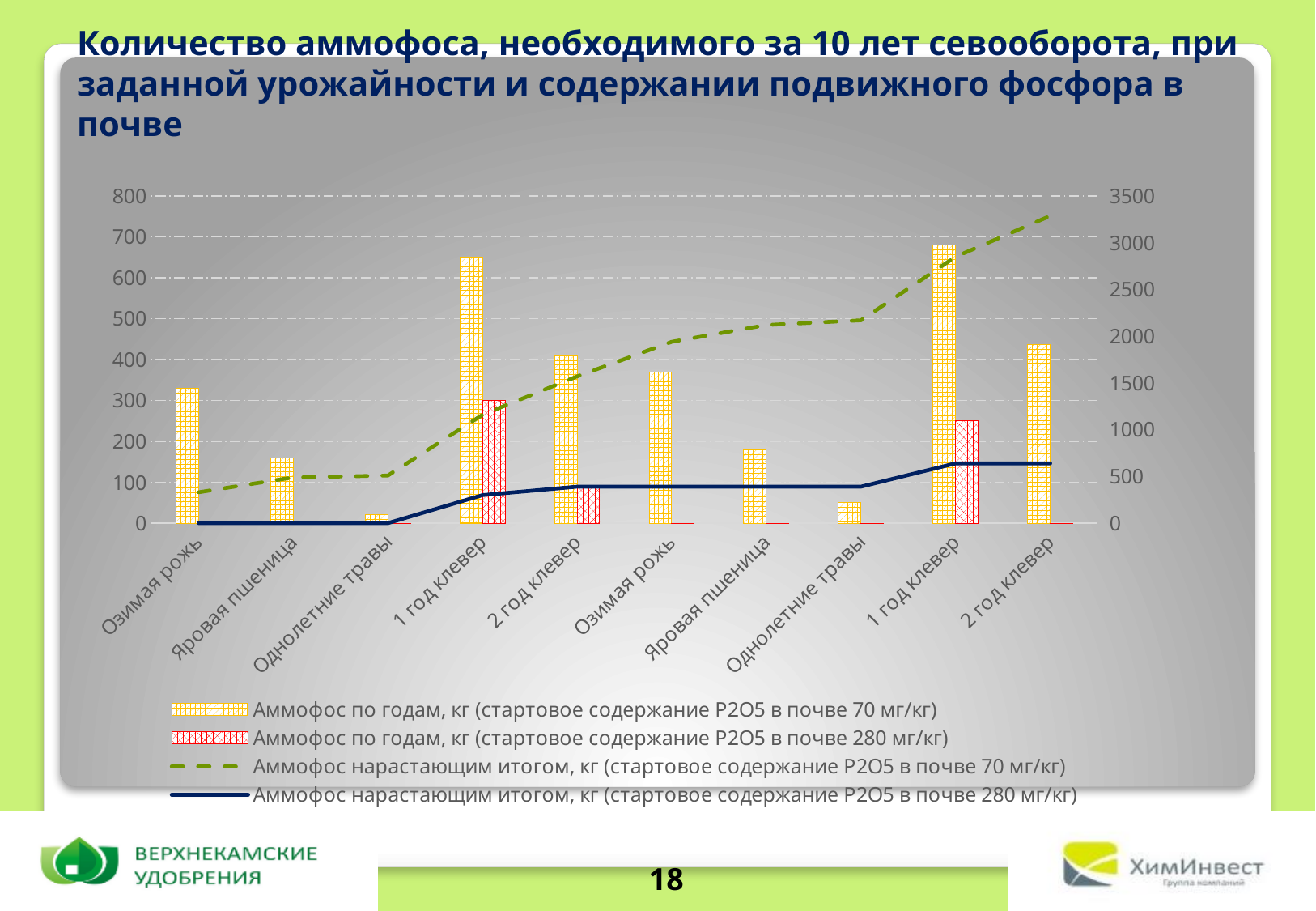
How many series does the legend list? 4 Is the yellow bar (стартовое содержание 70 мг/кг) for the first "Яровая пшеница" greater or less than 200? less Is the yellow bar (стартовое содержание 70 мг/кг) for the first "Озимая рожь" greater or less than 200? greater Which is larger: the yellow bar for the first "1 год клевер" or the yellow bar for the first "2 год клевер"? The first "1 год клевер" What kind of chart is shown on the slide? A combined bar and line chart Is the red bar (стартовое содержание 280 мг/кг) for the second "1 год клевер" greater or less than 200? greater Does the dashed green line (Аммофос нарастающим итогом, 70 мг/кг) rise or fall along the x axis? Rises How many categories are shown along the x axis? 10 Which category has the highest red bar (стартовое содержание 280 мг/кг)? The first "1 год клевер" What colour is the line for "Аммофос нарастающим итогом, кг (стартовое содержание P2O5 в почве 280 мг/кг)"? Dark blue (solid) What is the maximum value shown on the right-hand vertical axis? 3500